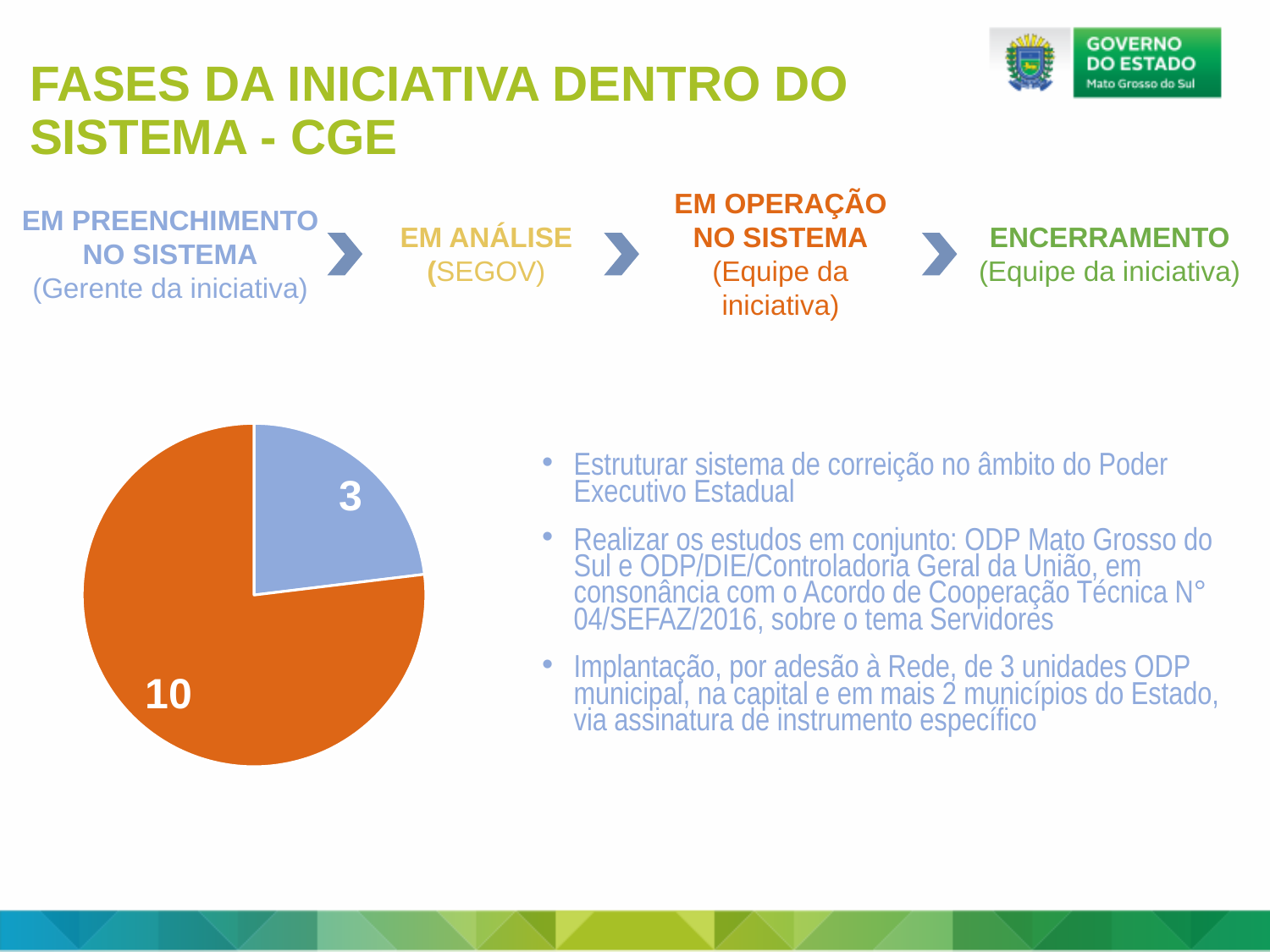
What two colours are used for the slices of the pie chart? Orange and blue Does the pie chart have a legend? No How many slices does the pie chart have? 2 What is the difference between the orange slice and the blue slice in the pie chart? 7 Which is larger in the pie chart, the blue slice or the orange slice? The orange slice What value is shown on the orange slice of the pie chart? 10 Which slice of the pie chart is the largest? The orange slice (10) Is the value of the orange slice in the pie chart greater or less than 5? greater What is the total of the values shown in the pie chart? 13 What kind of chart is shown on the slide? Pie chart Which slice of the pie chart is the smallest? The blue slice (3) What value is shown on the blue slice of the pie chart? 3